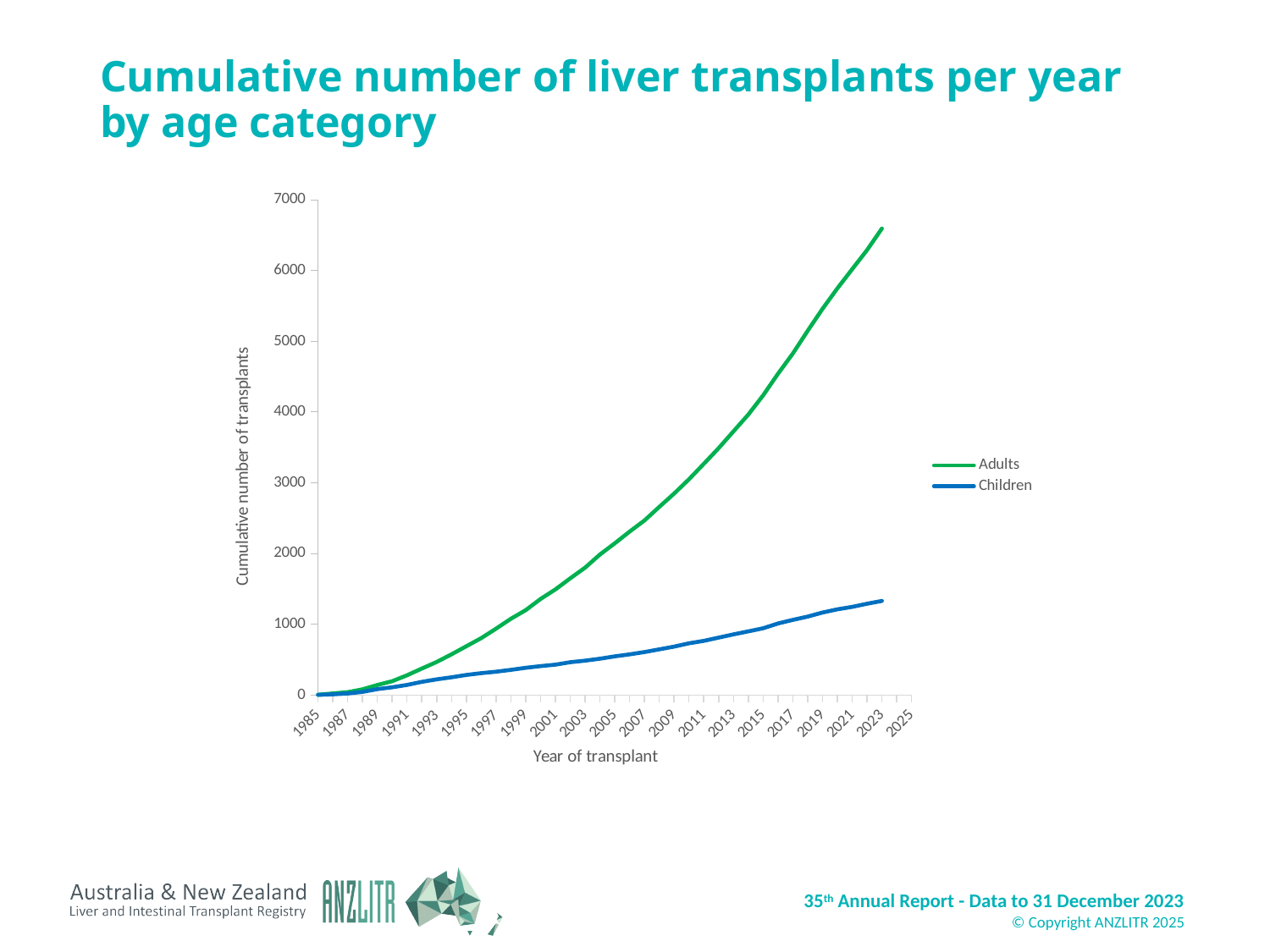
Is the value for Adults in 2023 greater or less than 6000? greater Which two series are shown in the legend? Adults and Children What kind of chart is shown on the slide? line chart Is the value for Children in 2009 greater or less than 1000? less Is the value for Children in 2023 greater or less than 1000? greater What is the title of the chart? Cumulative number of liver transplants per year by age category Do the values for Adults rise or fall from 1985 to 2023? rise Which series is the higher line throughout the chart, Adults or Children? Adults How many series does the legend list? 2 In 2023, which series has the larger cumulative number of transplants, Adults or Children? Adults Do the values for Children rise or fall along the x axis? rise